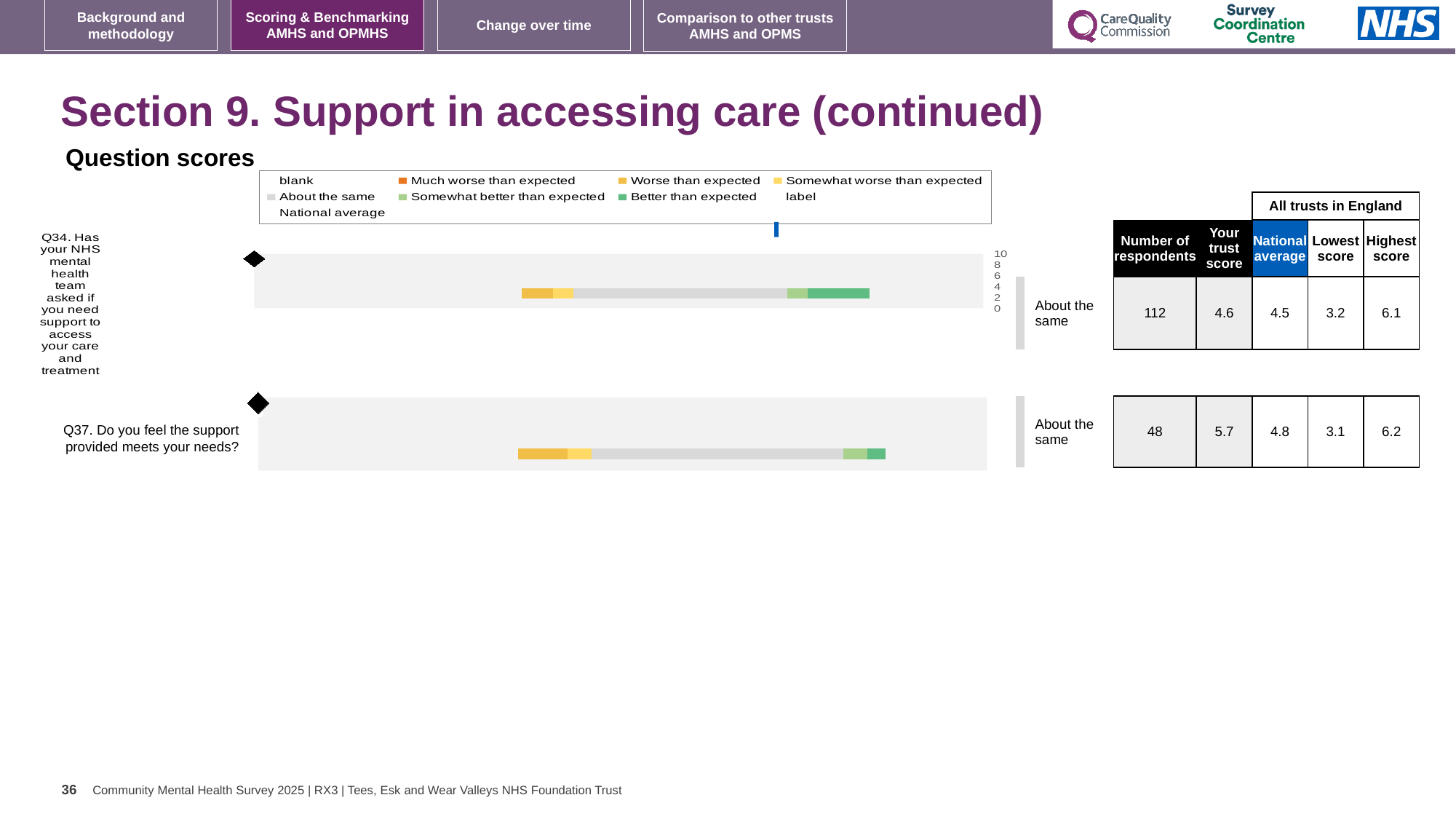
What is the trust score for Q37 (Do you feel the support provided meets your needs)? 5.7 Which is larger for Q37: the trust score or the national average? the trust score Which legend entry is shown in grey in the question scores chart? About the same What is the national average for Q34? 4.5 What kind of chart is used to show the question scores on this slide? bar chart What is the highest score among all trusts in England for Q37? 6.2 What is the number of respondents for Q34 (Has your NHS mental health team asked if you need support to access your care and treatment)? 112 What is the difference between the trust score and the national average for Q37? 0.9 What is the difference between the highest score and the lowest score for Q34? 2.9 How many questions are plotted in the question scores chart? 2 Which legend entry is shown in dark green in the question scores chart? Better than expected What benchmark category is given for Q34? About the same